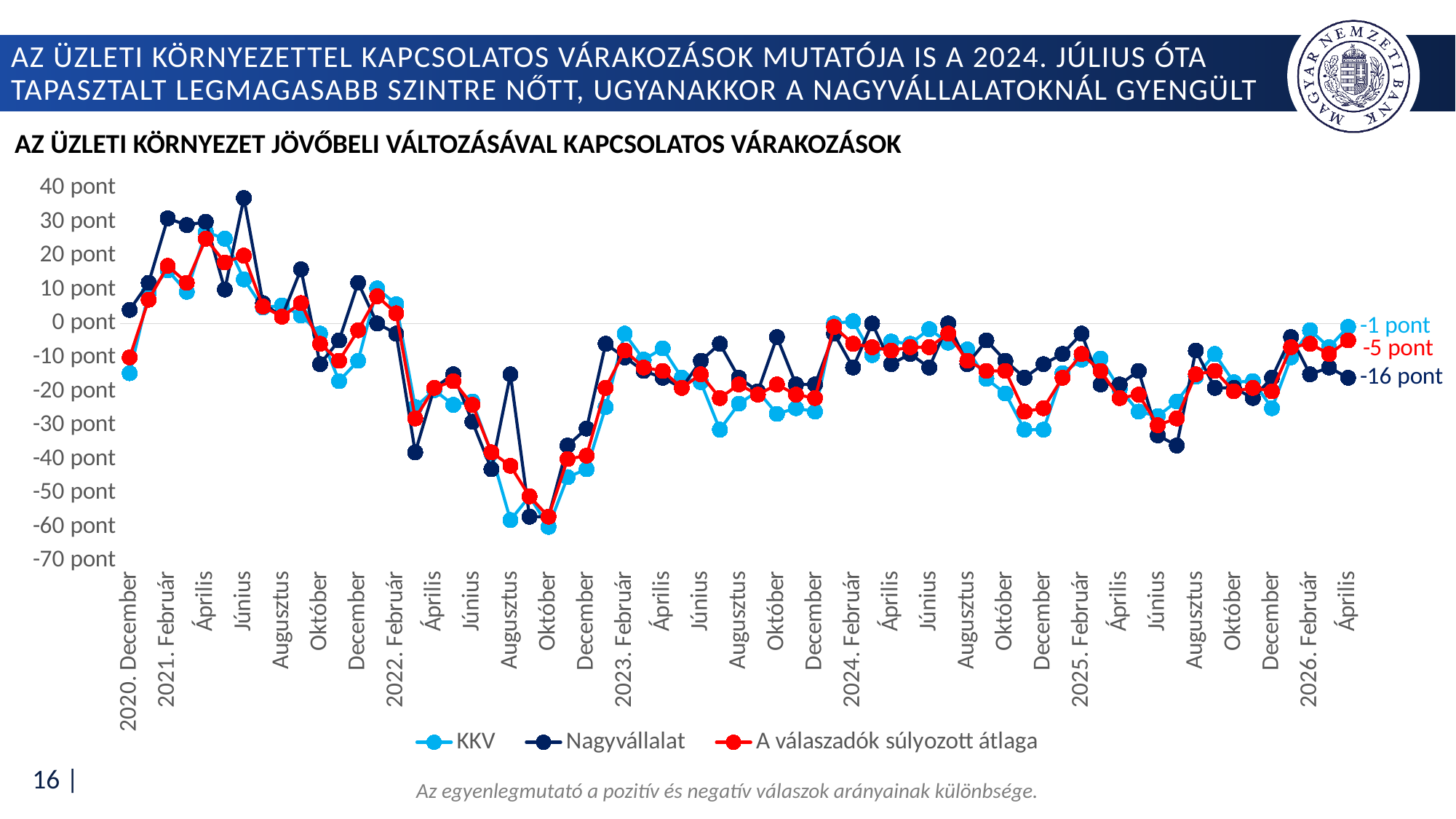
What kind of chart is shown on the slide? Line chart Is the value for Nagyvállalat in June 2021 greater or less than 30 pont? greater What is the title of the chart? AZ ÜZLETI KÖRNYEZET JÖVŐBELI VÁLTOZÁSÁVAL KAPCSOLATOS VÁRAKOZÁSOK What is the latest value shown for the KKV series (April 2026)? -1 pont At the last data point, is the value for KKV or for 'A válaszadók súlyozott átlaga' larger? KKV Is the value for KKV in October 2022 greater or less than -50 pont? less Which series has the highest value at the last data point (April 2026)? KKV How many series does the legend list? 3 Which series has the lowest value at the last data point (April 2026)? Nagyvállalat What is the latest value shown for the Nagyvállalat series (April 2026)? -16 pont What is the latest value shown for the 'A válaszadók súlyozott átlaga' series (April 2026)? -5 pont What is the difference between the latest KKV value and the latest Nagyvállalat value? 15 pont